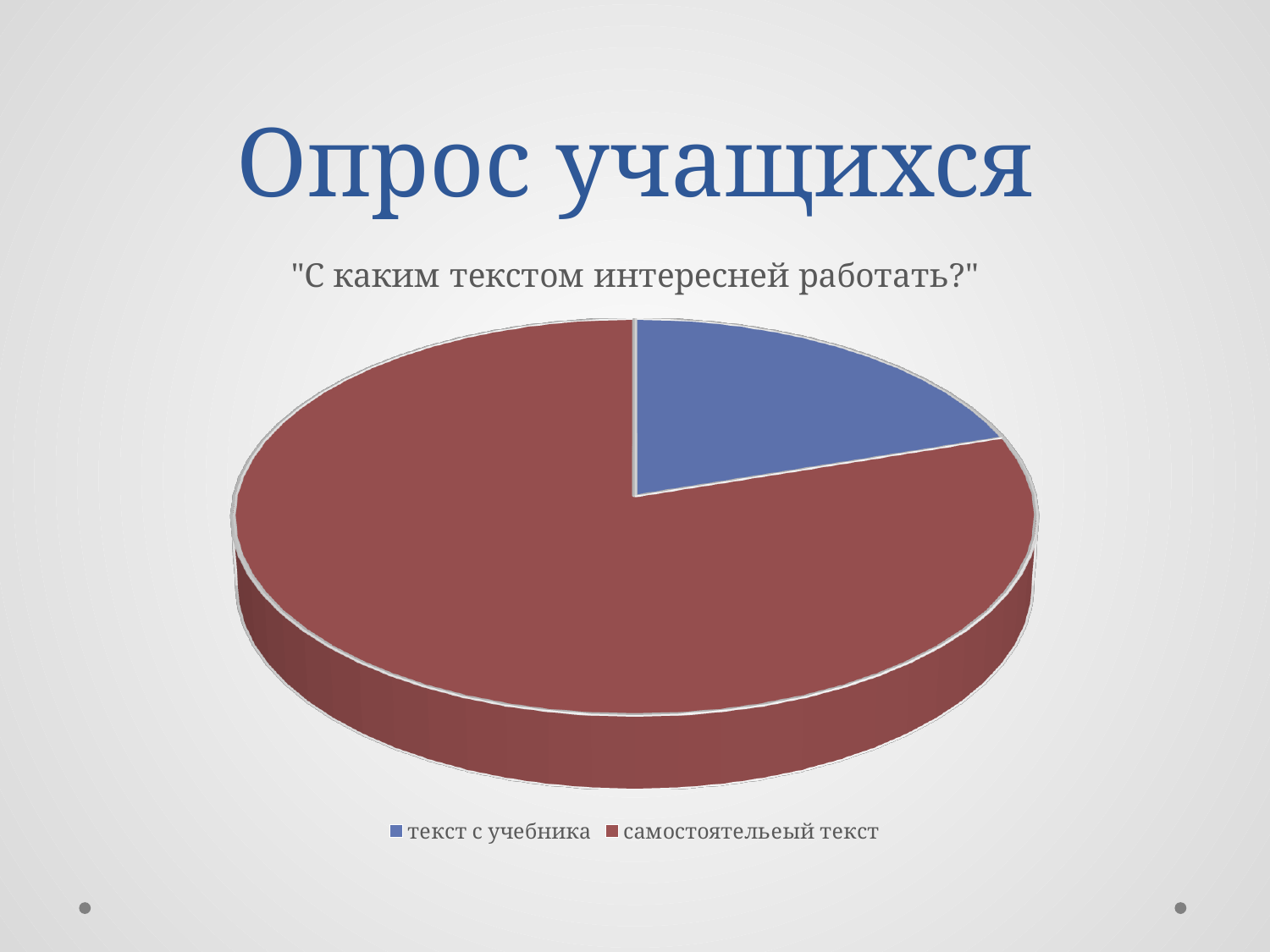
What kind of chart is shown on the slide? pie chart What is the title of the pie chart? "С каким текстом интересней работать?" What colour is the slice for "текст с учебника" in the pie chart? blue Which category has the smallest slice in the pie chart? текст с учебника Which category has the largest slice in the pie chart? самостоятельеый текст Which slice is larger: "текст с учебника" or "самостоятельеый текст"? самостоятельеый текст How many entries does the legend of the pie chart list? 2 How many slices does the pie chart have? 2